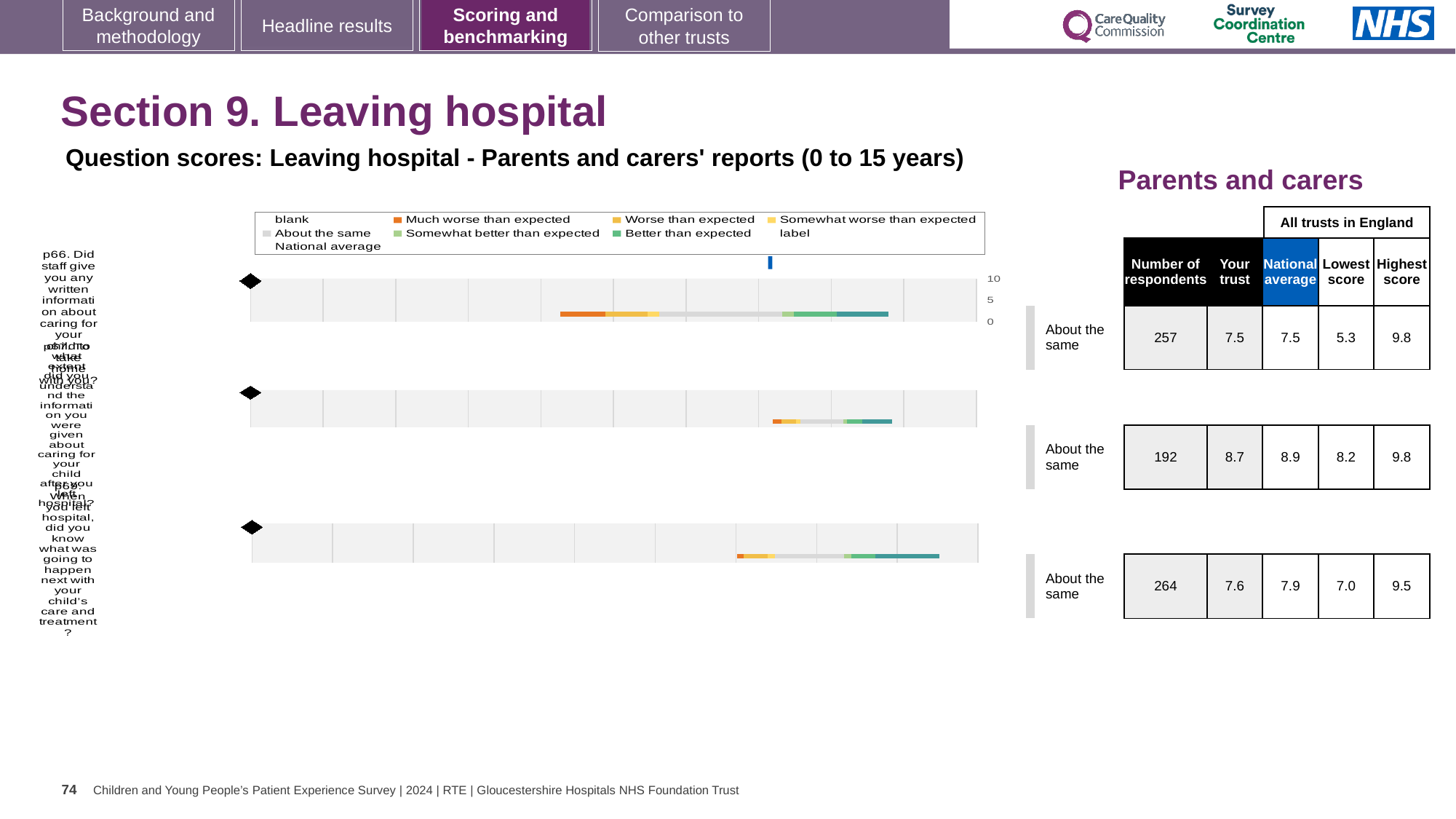
Which question row has the lowest number of respondents in the table? the middle row (192) Is the 'Your trust' score for the bottom row larger or smaller than its national average? smaller In the table, what is the lowest score for the top question row? 5.3 What benchmark category is shown beside each of the three question rows? About the same How many question bar charts are shown on the slide? 3 In the table, what is the national average for the bottom question row? 7.9 In the table, what is the highest score for the bottom question row? 9.5 In the table, what is the 'Your trust' score for the middle question row? 8.7 What kind of chart is used to show the question scores on this slide? bar chart Which question row has the highest 'Your trust' score in the table? the middle row (8.7) In the table, what is the number of respondents for the top question row? 257 What is the difference between the highest score and the lowest score for the middle question row? 1.6